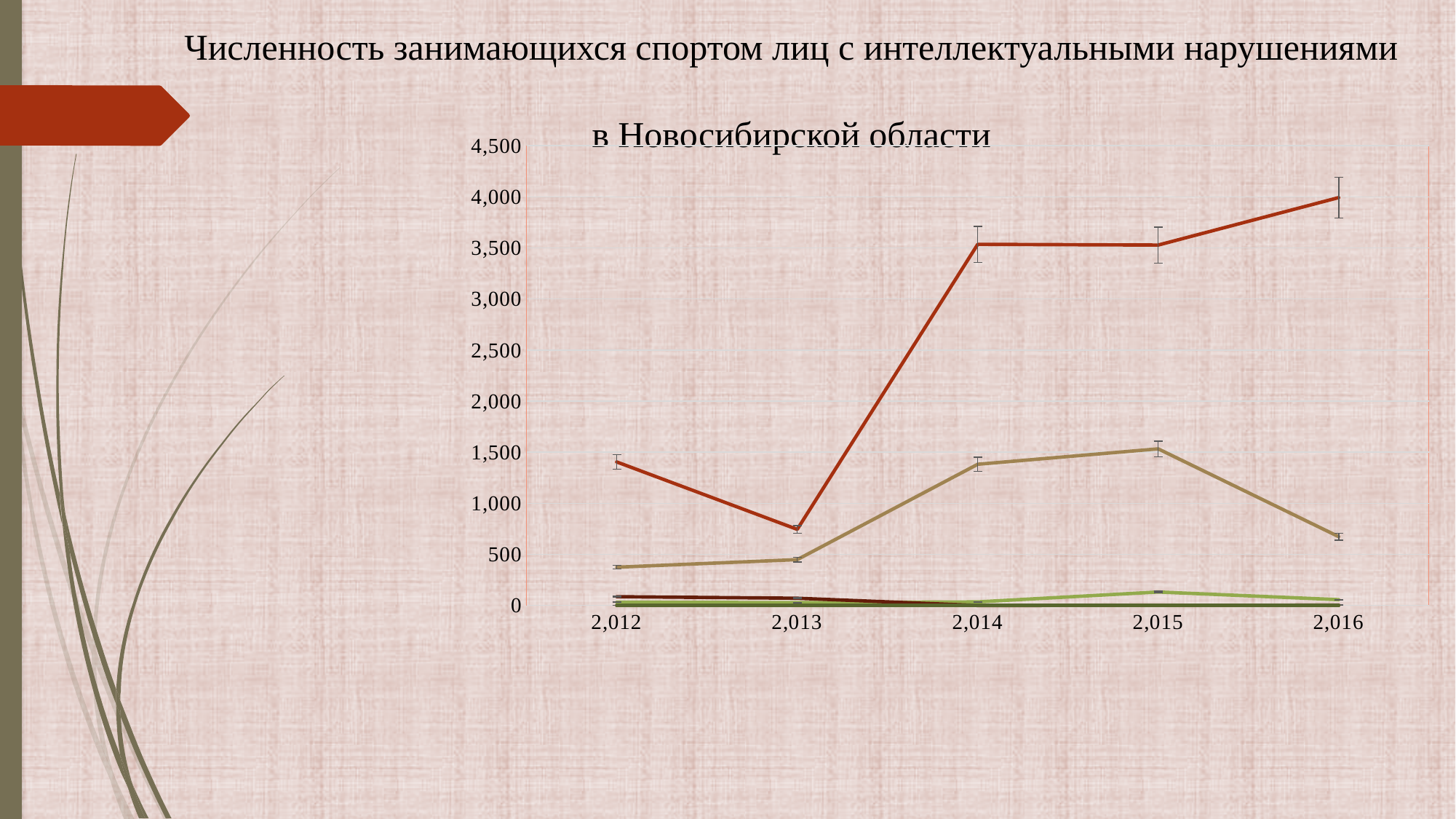
Is the value of the tan (light brown) line in 2,016 greater or less than 1,000? less What kind of chart is shown on the slide? line chart In 2,014, which line has the larger value, the red line or the tan (light brown) line? the red line How many years are shown on the x axis of the chart? 5 Does the red line rise or fall between 2,013 and 2,014? rise Is the value of the tan (light brown) line in 2,012 greater or less than 500? less In which year does the tan (light brown) line reach its highest value? 2,015 In which year does the red line reach its lowest value? 2,013 What is the title of the chart? Численность занимающихся спортом лиц с интеллектуальными нарушениями в Новосибирской области Is the value of the red line in 2,013 greater or less than 1,000? less In which year does the red line reach its highest value? 2,016